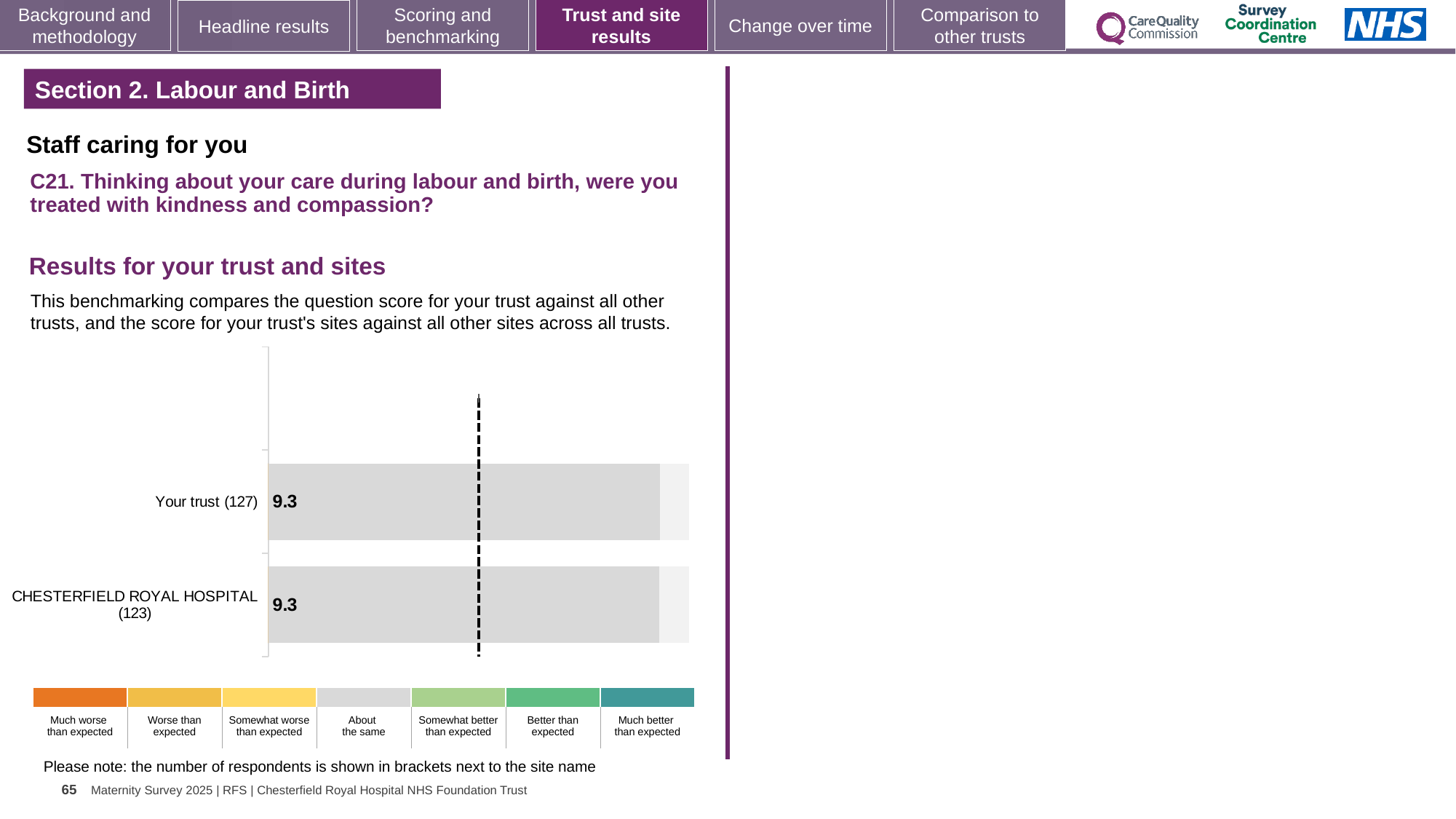
What is the difference between the score for Your trust (127) and the score for CHESTERFIELD ROYAL HOSPITAL (123)? 0.0 Which survey question does the chart report results for? C21. Thinking about your care during labour and birth, were you treated with kindness and compassion? What is the score for CHESTERFIELD ROYAL HOSPITAL (123)? 9.3 Is the score for Your trust (127) greater or less than 5? greater How many benchmark categories does the colour key below the chart list? 7 How many respondents are shown in brackets for CHESTERFIELD ROYAL HOSPITAL? 123 How many bars are plotted in the chart? 2 How many respondents are shown in brackets for Your trust? 127 What kind of chart is shown on the slide? Bar chart What is the score for Your trust (127)? 9.3 Which benchmark category does the grey colour of the bars correspond to in the colour key? About the same